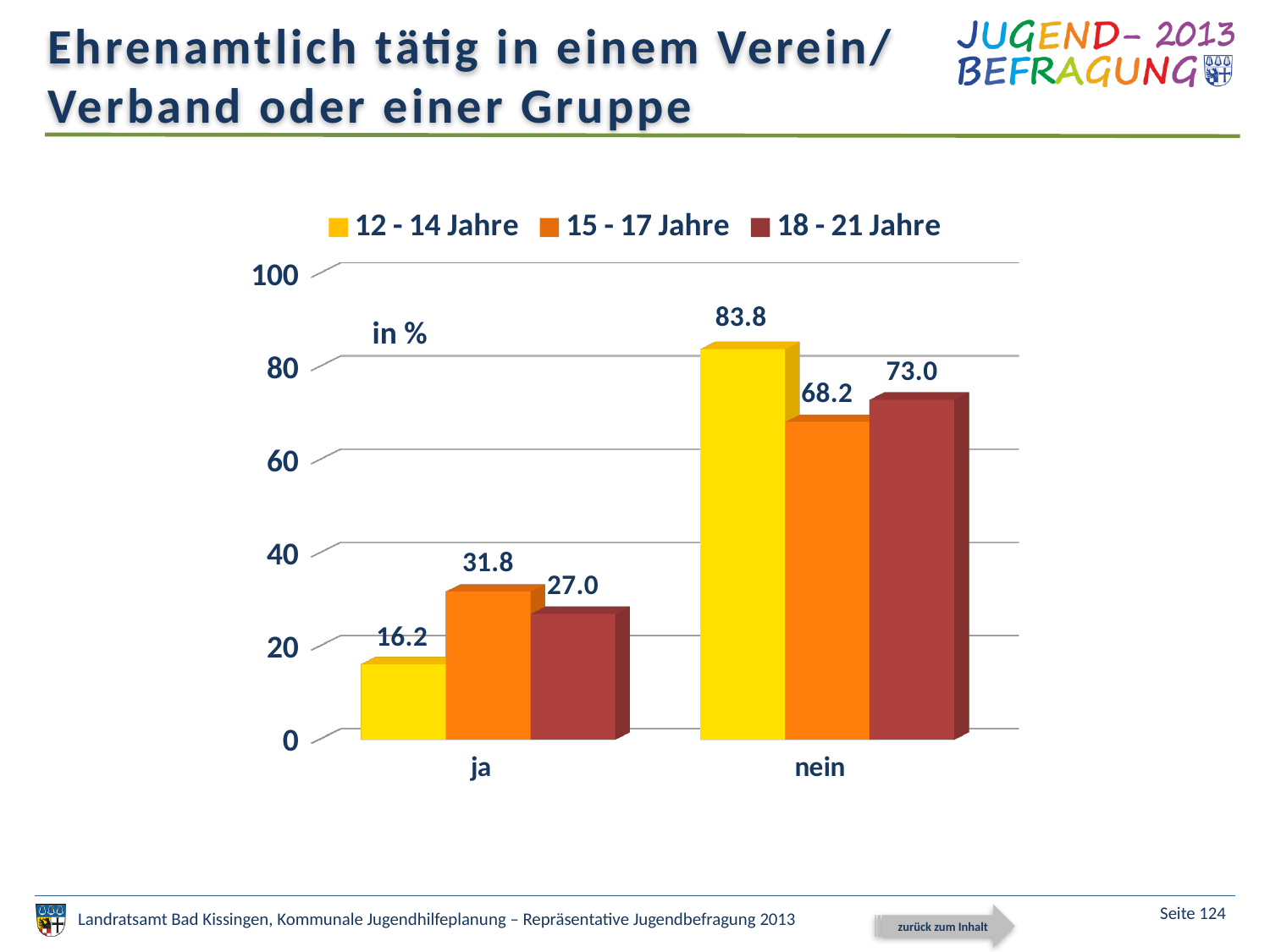
How many categories are shown on the x axis? 2 Which age group has the highest value in the "ja" category? 15 - 17 Jahre Which age group has the lowest value in the "nein" category? 15 - 17 Jahre What is the difference between the 15 - 17 Jahre and 12 - 14 Jahre values in the "ja" category? 15.6 What kind of chart is shown on the slide? bar chart Is the value for 18 - 21 Jahre in the "ja" category greater or less than 40? less What is the value for the 12 - 14 Jahre series in the "ja" category? 16.2 Which is larger in the "nein" category: the value for 12 - 14 Jahre or for 18 - 21 Jahre? 12 - 14 Jahre What is the value for the 18 - 21 Jahre series in the "nein" category? 73.0 How many series does the legend list? 3 What is the value for the 15 - 17 Jahre series in the "nein" category? 68.2 What unit is indicated on the chart for the values? in %